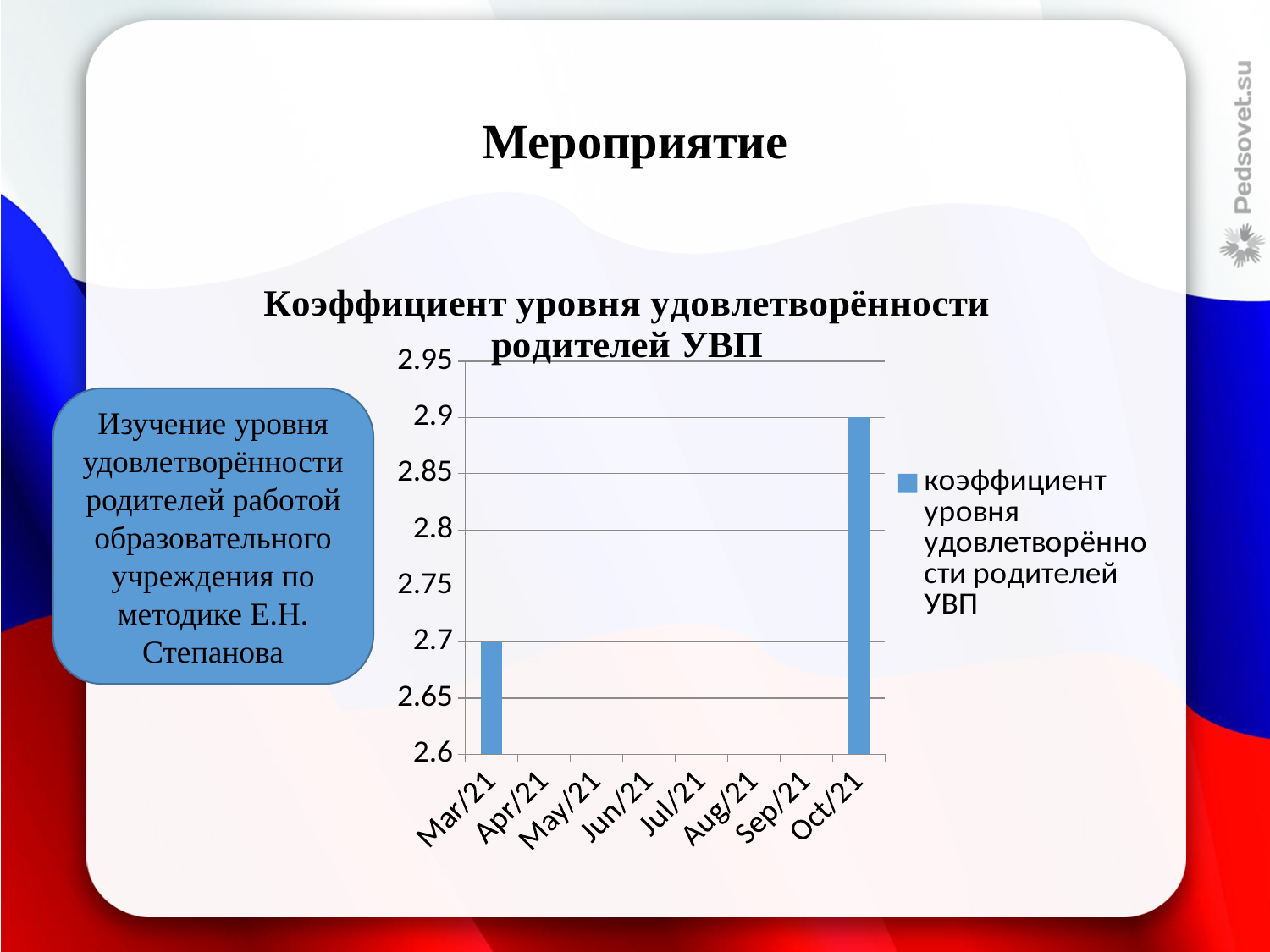
Is the value for Mar/21 greater or less than 2.8? less How many month labels are shown on the x axis? 8 What is the difference between the values for Oct/21 and Mar/21? 0.2 Which is larger, the value for Mar/21 or the value for Oct/21? Oct/21 Is the value for Oct/21 greater or less than 2.8? greater Which month has the highest value? Oct/21 How many series does the legend list? 1 Which of the two plotted months has the lower value? Mar/21 What is the value for Oct/21? 2.9 What is the value for Mar/21? 2.7 What type of chart is shown on the slide? bar chart Does the value rise or fall from Mar/21 to Oct/21? rise